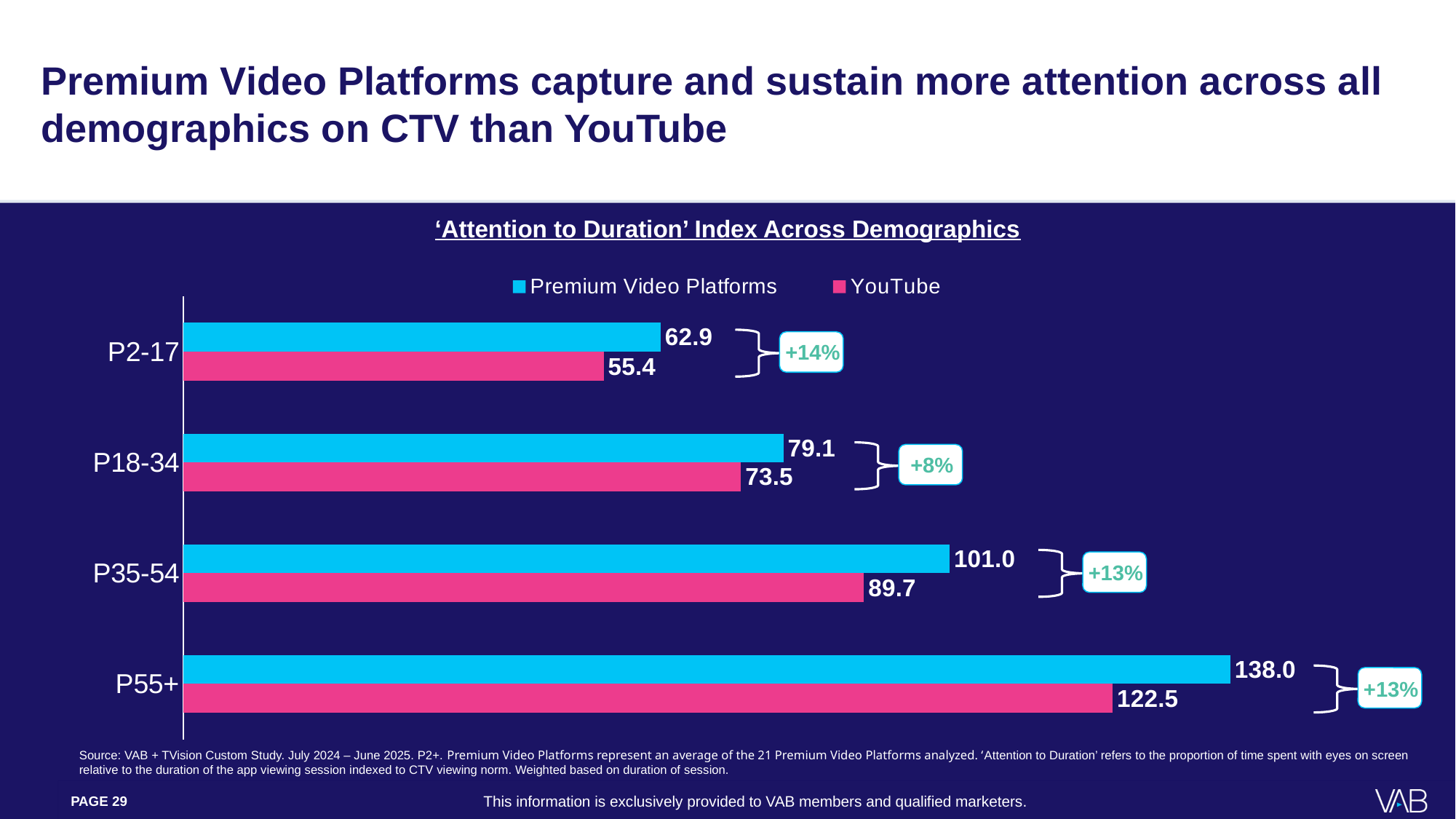
What is the difference between the Premium Video Platforms values for P55+ and P35-54? 37.0 What percentage difference is annotated for the P18-34 group? +8% Which demographic has the highest Premium Video Platforms value? P55+ What kind of chart is shown on the slide? Bar chart What is the difference between the Premium Video Platforms and YouTube values for P18-34? 5.6 Which demographic has the lowest YouTube value? P2-17 Which is larger for P35-54, the Premium Video Platforms value or the YouTube value? Premium Video Platforms How many series does the legend list? 2 What is the Premium Video Platforms value for P2-17? 62.9 What is the YouTube value for P55+? 122.5 How many demographic categories are shown in the chart? 4 What is the YouTube value for P35-54? 89.7